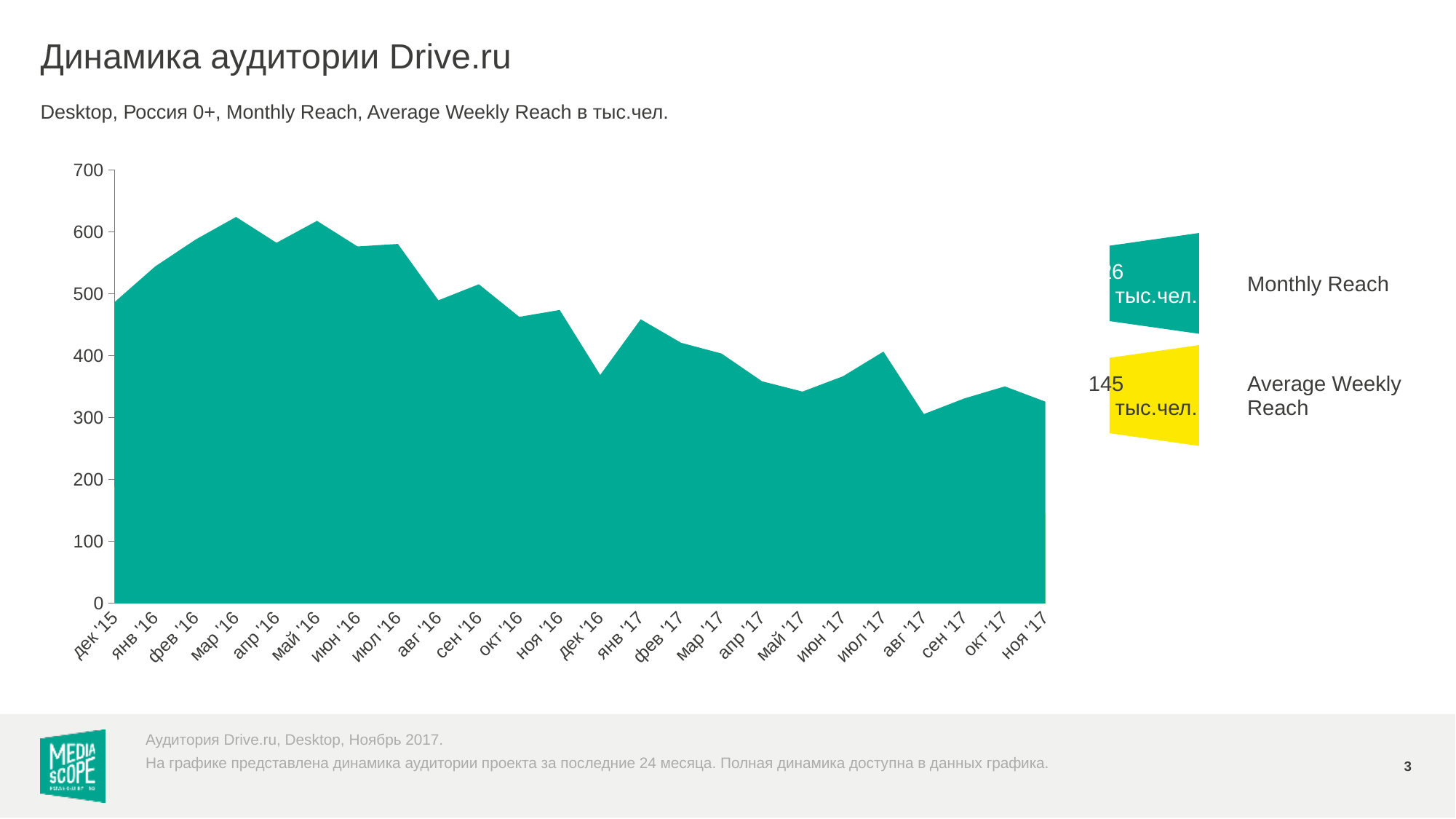
What is the title of the slide? Динамика аудитории Drive.ru Which is larger, the Monthly Reach for мар '16 or for дек '16? мар '16 Is the Monthly Reach for май '17 greater or less than 400? less How many months are plotted along the x axis of the chart? 24 What kind of chart is shown on the slide? area chart Is the Monthly Reach for мар '16 greater or less than 600? greater What Average Weekly Reach value is shown next to the chart? 145 тыс.чел. Which month has the highest Monthly Reach on the chart? мар '16 Is the Monthly Reach for дек '16 greater or less than 400? less Overall, does Monthly Reach rise or fall from дек '15 to ноя '17? fall